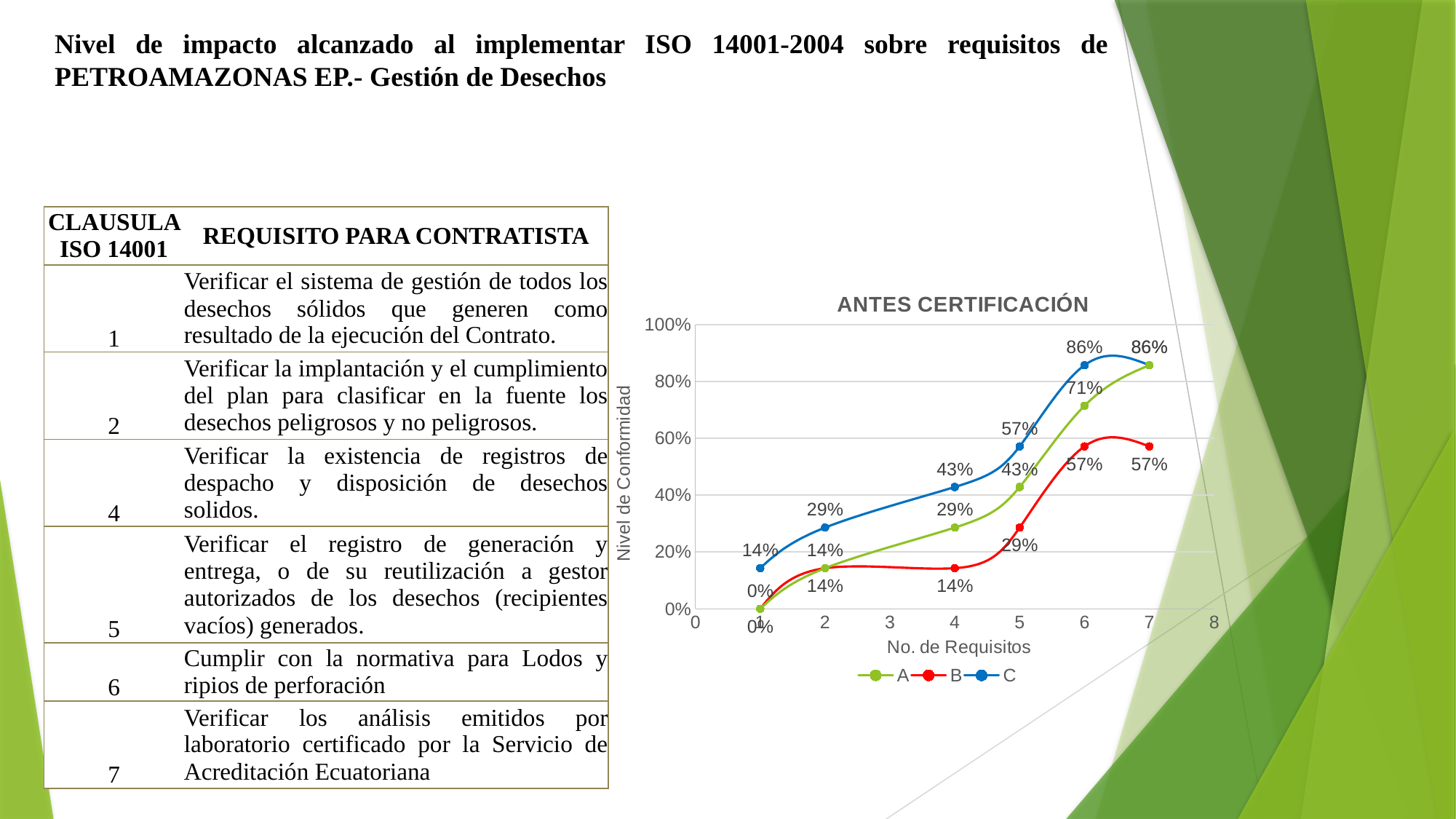
At requisito 4, which series has the larger value, A or B? A What type of chart is shown on the slide? line chart What is the label of the vertical axis of the chart? Nivel de Conformidad What is the value of series C at requisito 6? 86% How many series does the legend of the chart list? 3 What is the value of series B at requisito 7? 57% What is the title of the chart? ANTES CERTIFICACIÓN What is the value of series A at requisito 6? 71% What is the value of series B at requisito 5? 29% Which series has the highest value at requisito 2? C What is the value of series A at requisito 7? 86% At requisito 5, what is the difference between the value of series C and the value of series A? 14%